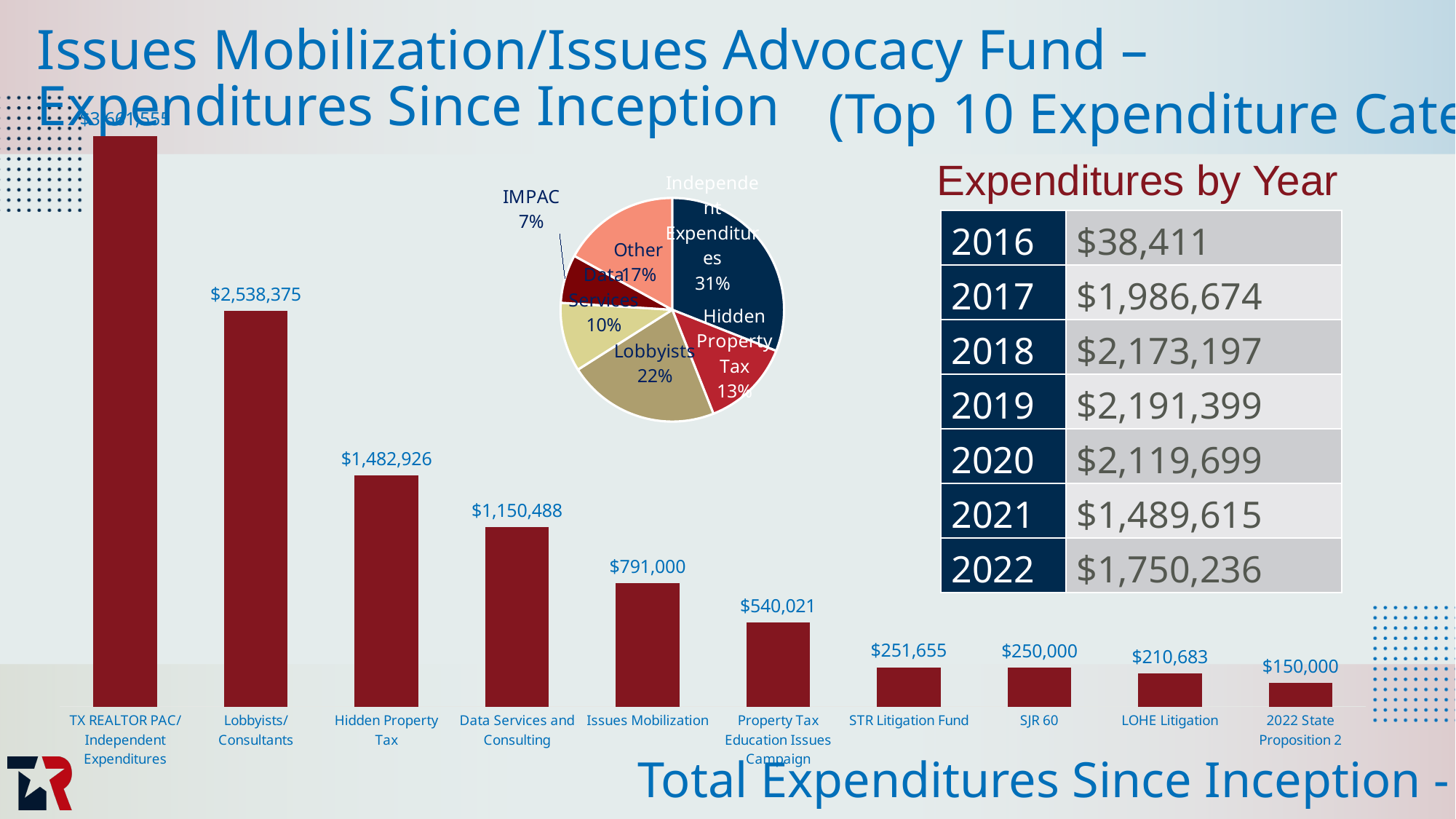
What kind of chart is the chart at the bottom of the slide? bar chart In the bar chart, which is larger: SJR 60 or LOHE Litigation? SJR 60 In the pie chart, which slice is the largest? Independent Expenditures In the bar chart, what is the value for STR Litigation Fund? $251,655 In the pie chart, what share does Lobbyists have? 22% In the bar chart, which category has the lowest value? 2022 State Proposition 2 In the bar chart, what is the value for Lobbyists/Consultants? $2,538,375 In the bar chart, what is the value for Issues Mobilization? $791,000 In the bar chart, what is the value for Hidden Property Tax? $1,482,926 In the bar chart, what is the difference between Data Services and Consulting and Property Tax Education Issues Campaign? $610,467 In the bar chart, which category has the highest value? TX REALTOR PAC/ Independent Expenditures How many categories are shown in the bar chart? 10